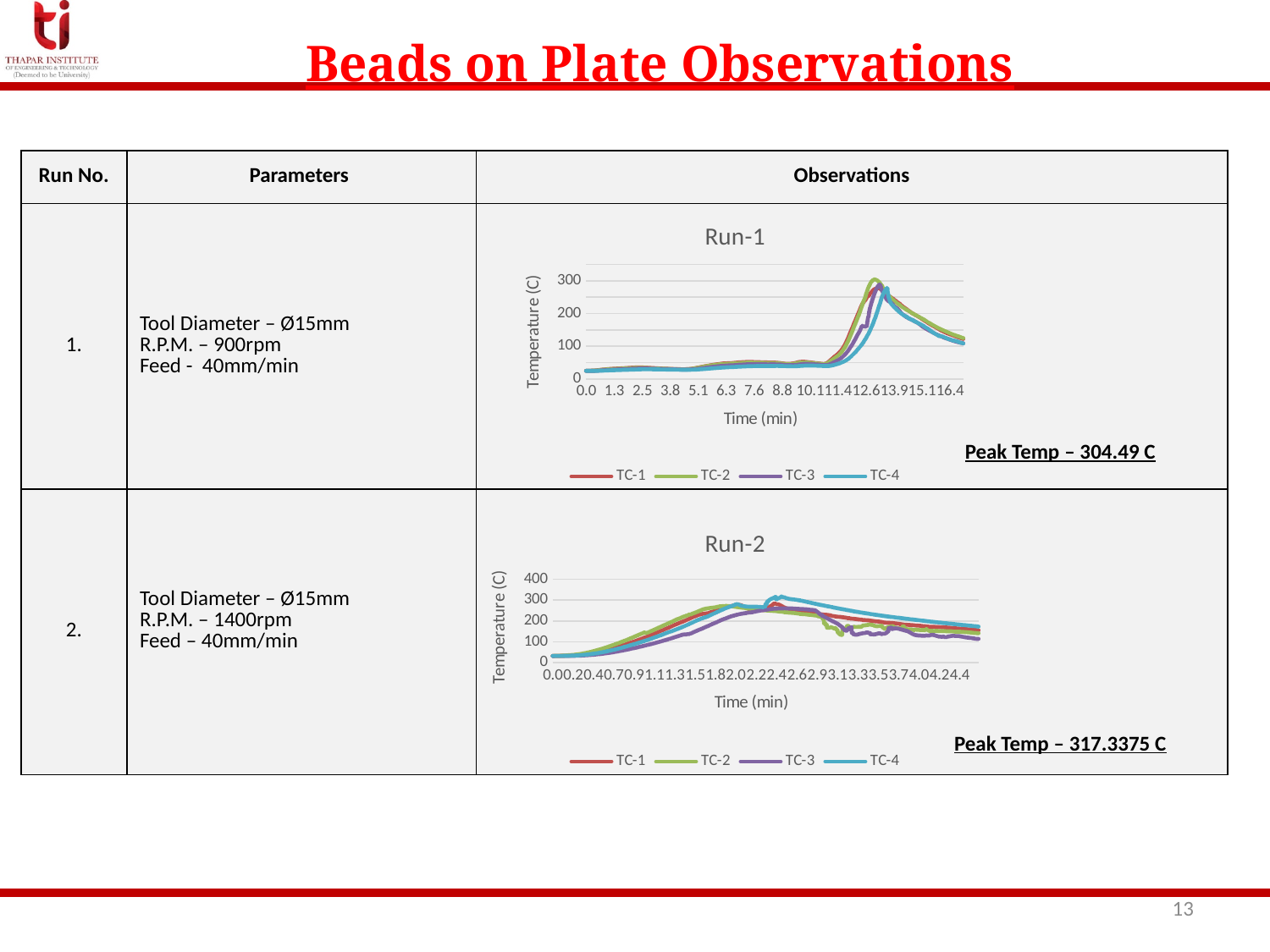
In the Run-1 chart, is the highest temperature reached greater or less than 100? greater In the Run-2 chart, is the highest temperature reached greater or less than 200? greater What kind of chart is the Run-2 chart? line chart In the Run-2 chart, is the value of TC-4 at the last time point greater or less than 200? less How many series does the legend of the Run-2 chart list? 4 What is the y-axis label of the Run-1 chart? Temperature (C) What are the legend entries of the Run-2 chart? TC-1, TC-2, TC-3, TC-4 What kind of chart is the Run-1 chart? line chart How many series does the legend of the Run-1 chart list? 4